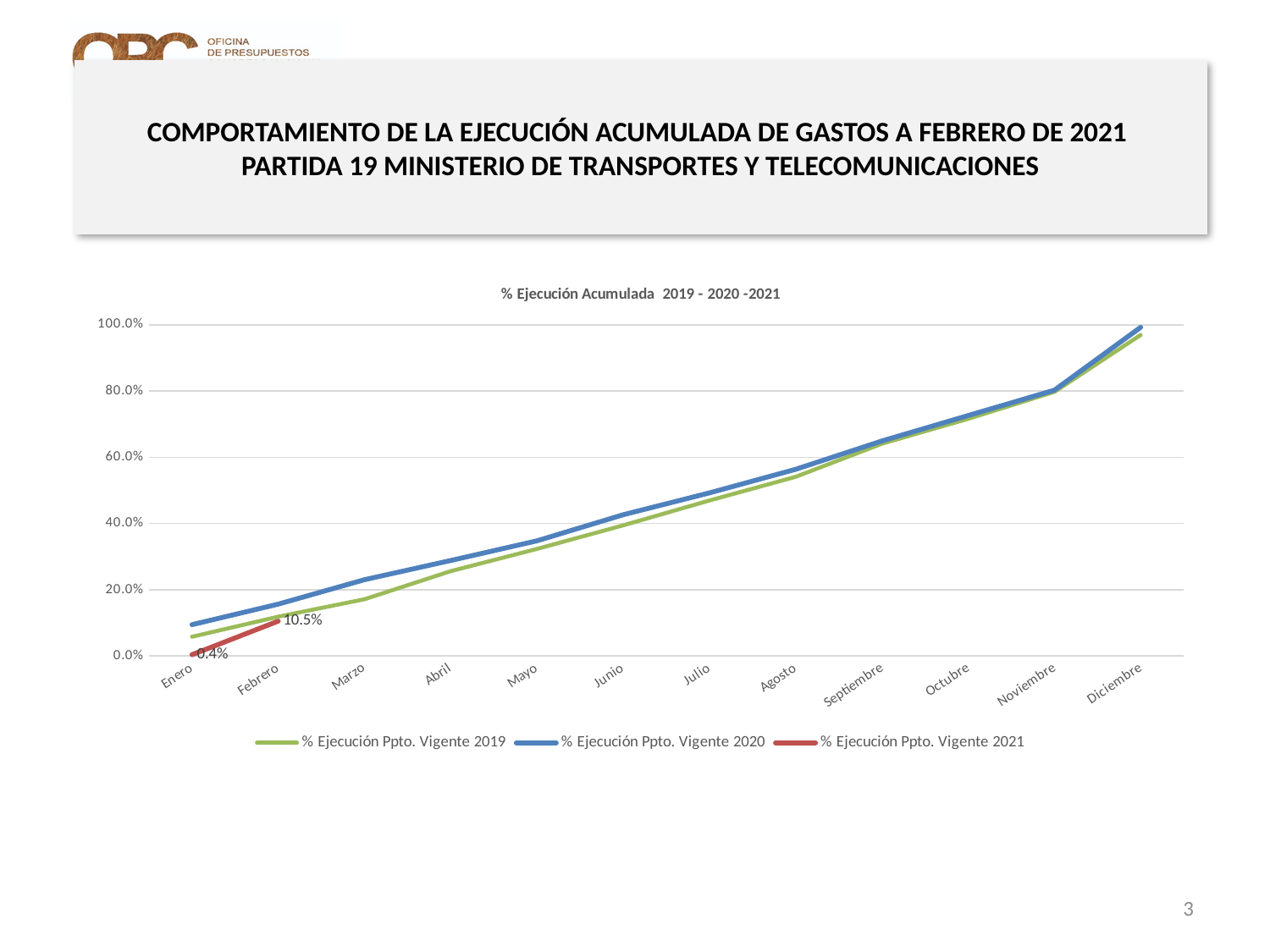
What is the value of % Ejecución Ppto. Vigente 2021 for Enero? 0.4% Is the value for % Ejecución Ppto. Vigente 2020 in Diciembre greater or less than 80.0%? greater What is the value of % Ejecución Ppto. Vigente 2021 for Febrero? 10.5% In Marzo, which series has the higher value: % Ejecución Ppto. Vigente 2019 or % Ejecución Ppto. Vigente 2020? % Ejecución Ppto. Vigente 2020 How many series does the chart legend list? 3 By how much did % Ejecución Ppto. Vigente 2021 increase from Enero to Febrero? 10.1% What kind of chart is shown on the slide? line chart What colour is the line for % Ejecución Ppto. Vigente 2021? red What is the title of the chart? % Ejecución Acumulada 2019 - 2020 -2021 Is the value for % Ejecución Ppto. Vigente 2019 in Agosto greater or less than 60.0%? less Does the % Ejecución Ppto. Vigente 2020 line rise or fall from Enero to Diciembre? rise How many months are shown along the x axis of the chart? 12